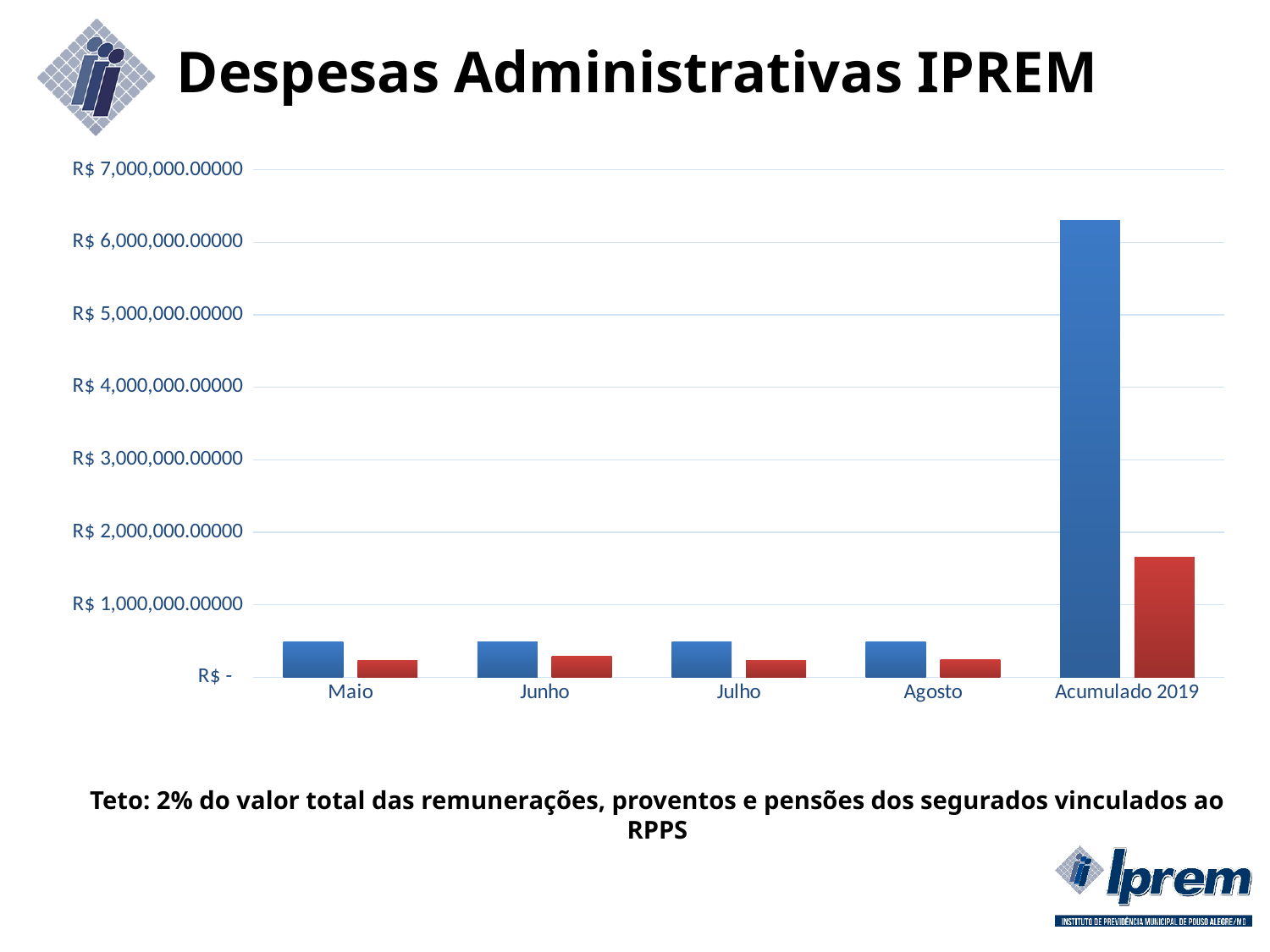
How many categories are shown on the x axis of the chart? 5 For Acumulado 2019, which bar is larger, the blue bar or the red bar? the blue bar What is the highest value labelled on the vertical axis of the chart? R$ 7,000,000.00000 Is the value of the blue bar for Maio greater or less than R$ 1,000,000.00000? less Which category has the tallest bar in the chart? Acumulado 2019 What is the title of the slide containing the chart? Despesas Administrativas IPREM Is the value of the red bar for Acumulado 2019 greater or less than R$ 2,000,000.00000? less Is the value of the blue bar for Acumulado 2019 greater or less than R$ 6,000,000.00000? greater For Junho, which bar is larger, the blue bar or the red bar? the blue bar What kind of chart is shown on the slide? bar chart